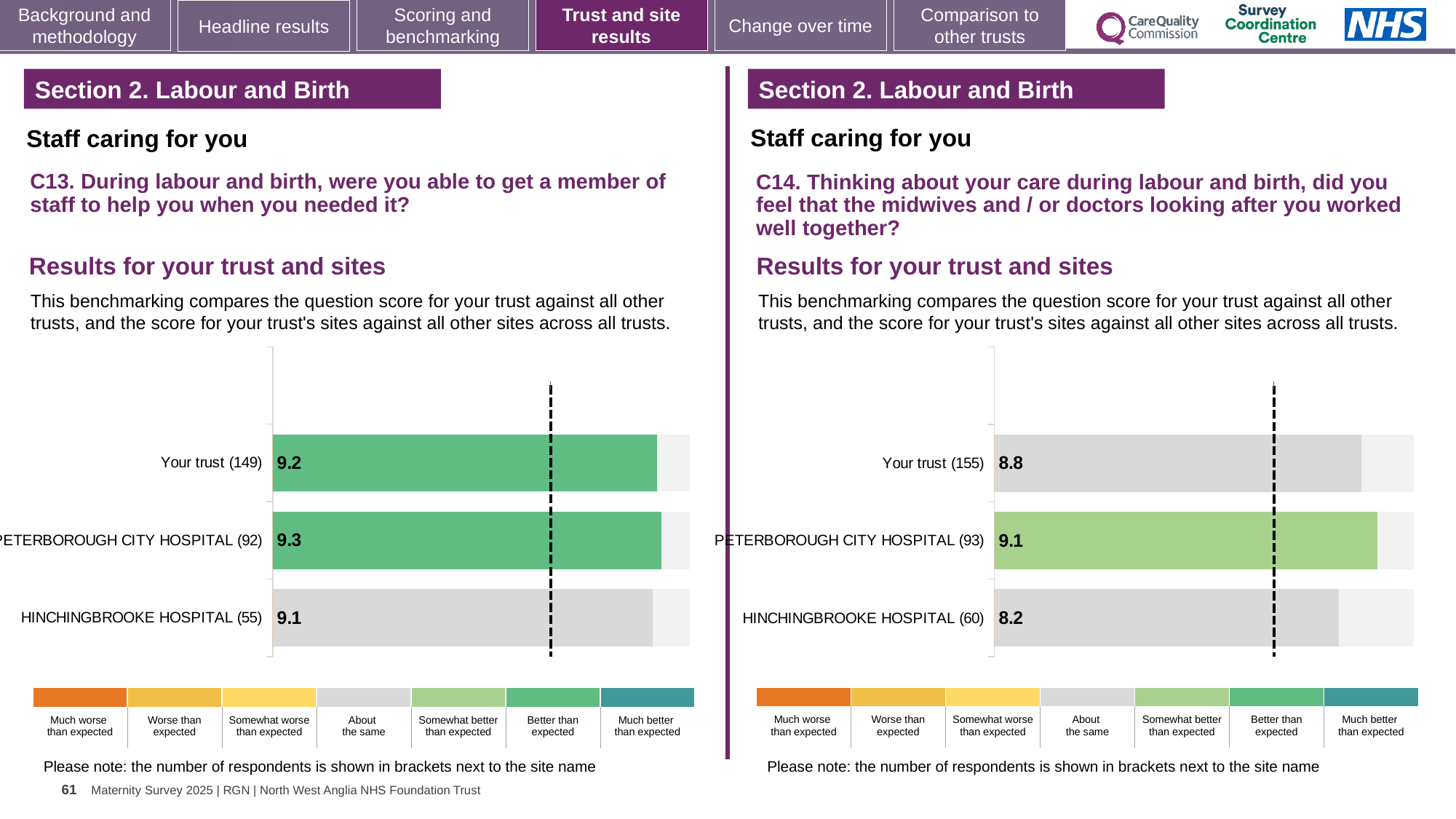
In the C14 chart on the right, what is the score for Your trust? 8.8 In the C14 chart on the right, what is the score for HINCHINGBROOKE HOSPITAL? 8.2 In the C14 chart on the right, how many respondents are shown in brackets for HINCHINGBROOKE HOSPITAL? 60 In the C13 chart on the left, what is the difference between the scores for PETERBOROUGH CITY HOSPITAL and HINCHINGBROOKE HOSPITAL? 0.2 In the C13 chart on the left, what is the score for HINCHINGBROOKE HOSPITAL? 9.1 In the C13 chart on the left, what is the score for PETERBOROUGH CITY HOSPITAL? 9.3 What type of chart is used in the C14 chart on the right? Bar chart In the C13 chart on the left, how many bars are plotted? 3 In the C13 chart on the left, what is the score for Your trust? 9.2 In the C14 chart on the right, what is the difference between the scores for PETERBOROUGH CITY HOSPITAL and HINCHINGBROOKE HOSPITAL? 0.9 In the C14 chart on the right, which site or trust has the lowest score? HINCHINGBROOKE HOSPITAL In the C14 chart on the right, which site or trust has the highest score? PETERBOROUGH CITY HOSPITAL